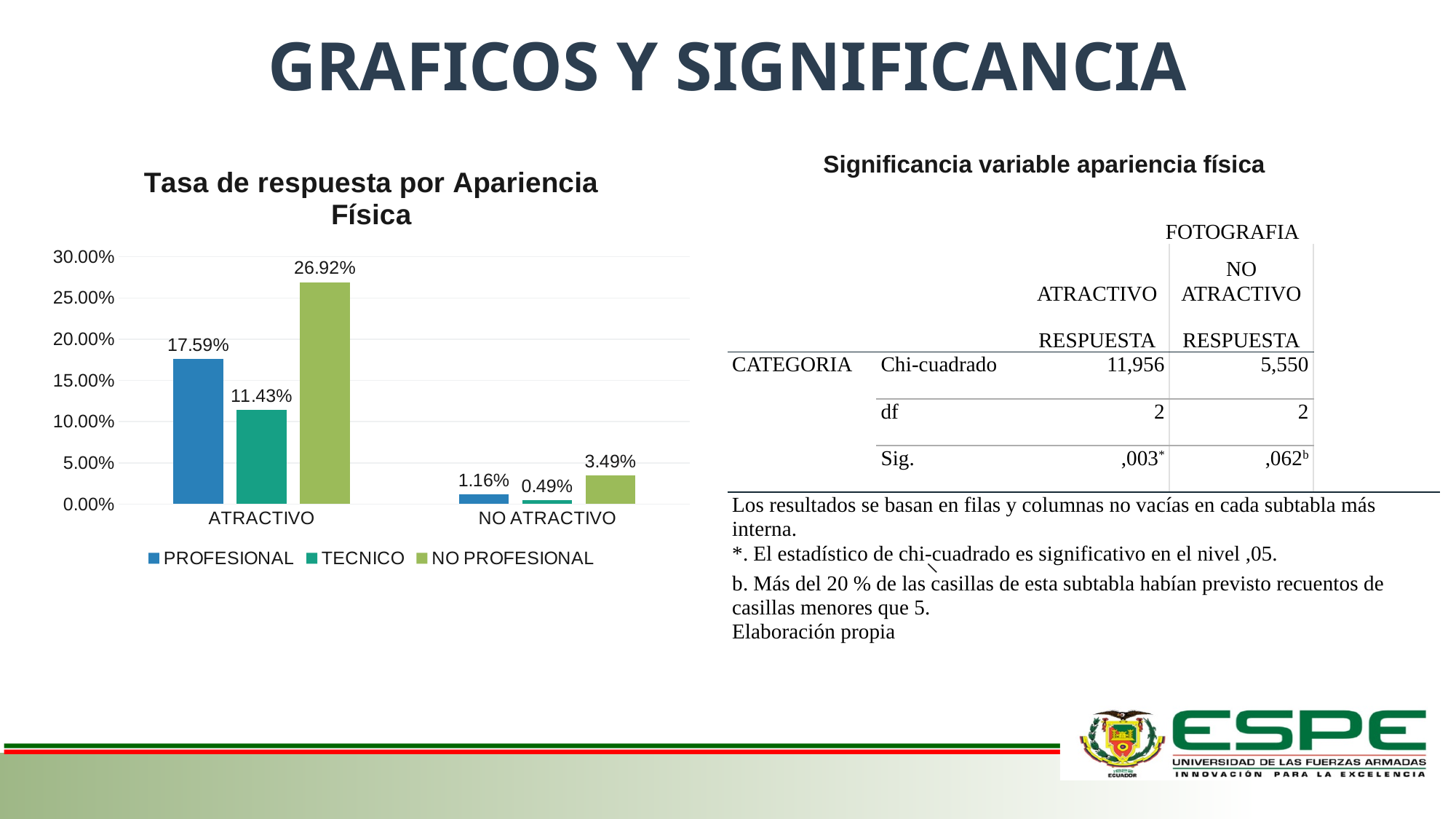
What is the value for TECNICO in the NO ATRACTIVO category? 0.49% Which series has the lowest value in the NO ATRACTIVO category? TECNICO Is the value for NO PROFESIONAL in the ATRACTIVO category greater or less than 25.00%? greater Which series has the highest value in the ATRACTIVO category? NO PROFESIONAL What is the value for NO PROFESIONAL in the ATRACTIVO category? 26.92% How many series does the chart legend list? 3 What is the value for PROFESIONAL in the ATRACTIVO category? 17.59% What kind of chart is shown on the slide? bar chart What is the difference between the NO PROFESIONAL and PROFESIONAL values in the ATRACTIVO category? 9.33% How many categories are shown on the x axis of the chart? 2 What is the title of the chart? Tasa de respuesta por Apariencia Física Which is larger: the PROFESIONAL value for ATRACTIVO or the TECNICO value for ATRACTIVO? PROFESIONAL value for ATRACTIVO